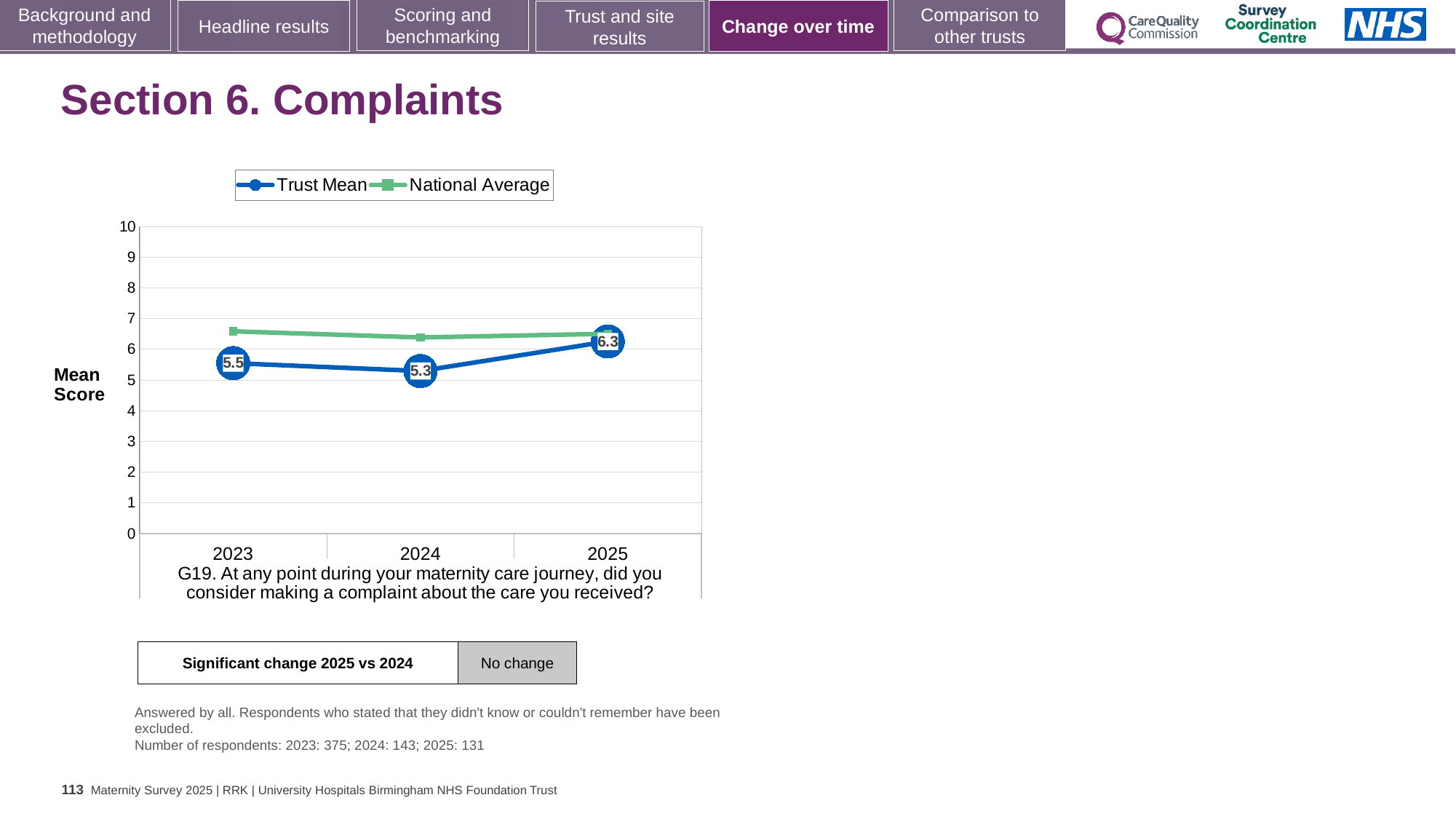
In which year is the Trust Mean score lowest? 2024 What is the Trust Mean score for 2025? 6.3 What is the difference between the Trust Mean score in 2025 and in 2024? 1.0 In which year is the Trust Mean score highest? 2025 What is the Trust Mean score for 2024? 5.3 How many years are shown on the x axis of the chart? 3 What is the Trust Mean score for 2023? 5.5 What kind of chart is shown on the slide? line chart How many series does the chart legend list? 2 In 2023, which is higher, the Trust Mean or the National Average? National Average Which year has the larger Trust Mean score, 2023 or 2024? 2023 Is the National Average value for 2023 greater or less than 6? greater